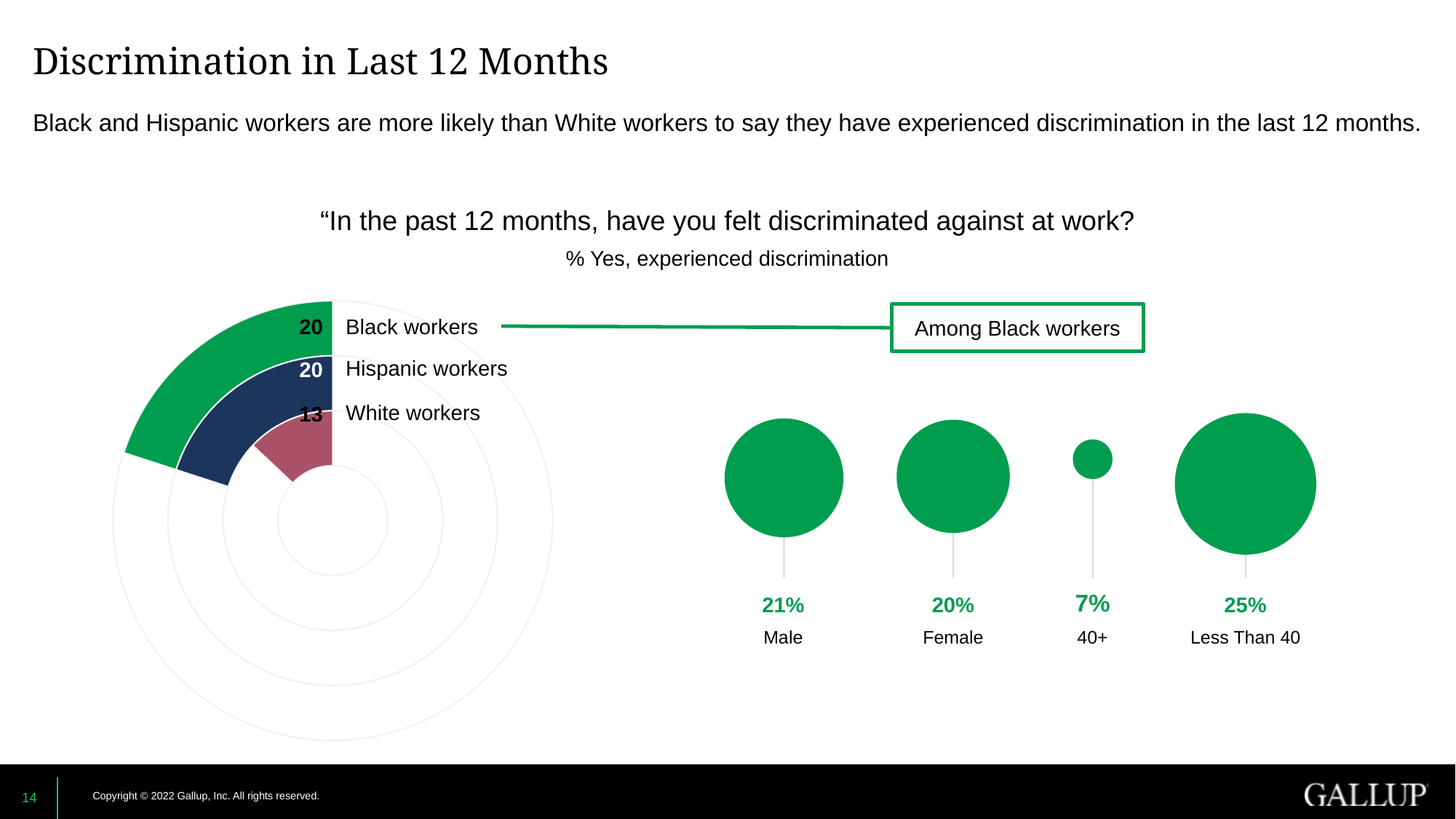
In the 'Among Black workers' chart on the right, what is the value for Male? 21% In the 'Among Black workers' chart on the right, which category has the highest value? Less Than 40 In the radial chart on the left, how many worker groups are shown? 3 In the radial chart on the left, what is the value for Hispanic workers? 20 In the 'Among Black workers' chart on the right, what is the difference between the values for Less Than 40 and 40+? 18% In the radial chart on the left, which group has the lowest value? White workers In the 'Among Black workers' chart on the right, which is larger, the value for Male or the value for Female? Male In the radial chart on the left, what is the difference between the values for Black workers and White workers? 7 In the 'Among Black workers' chart on the right, what is the value for 40+? 7% In the radial chart on the left, what is the value for White workers? 13 In the 'Among Black workers' chart on the right, which category has the lowest value? 40+ In the 'Among Black workers' chart on the right, how many categories are shown? 4